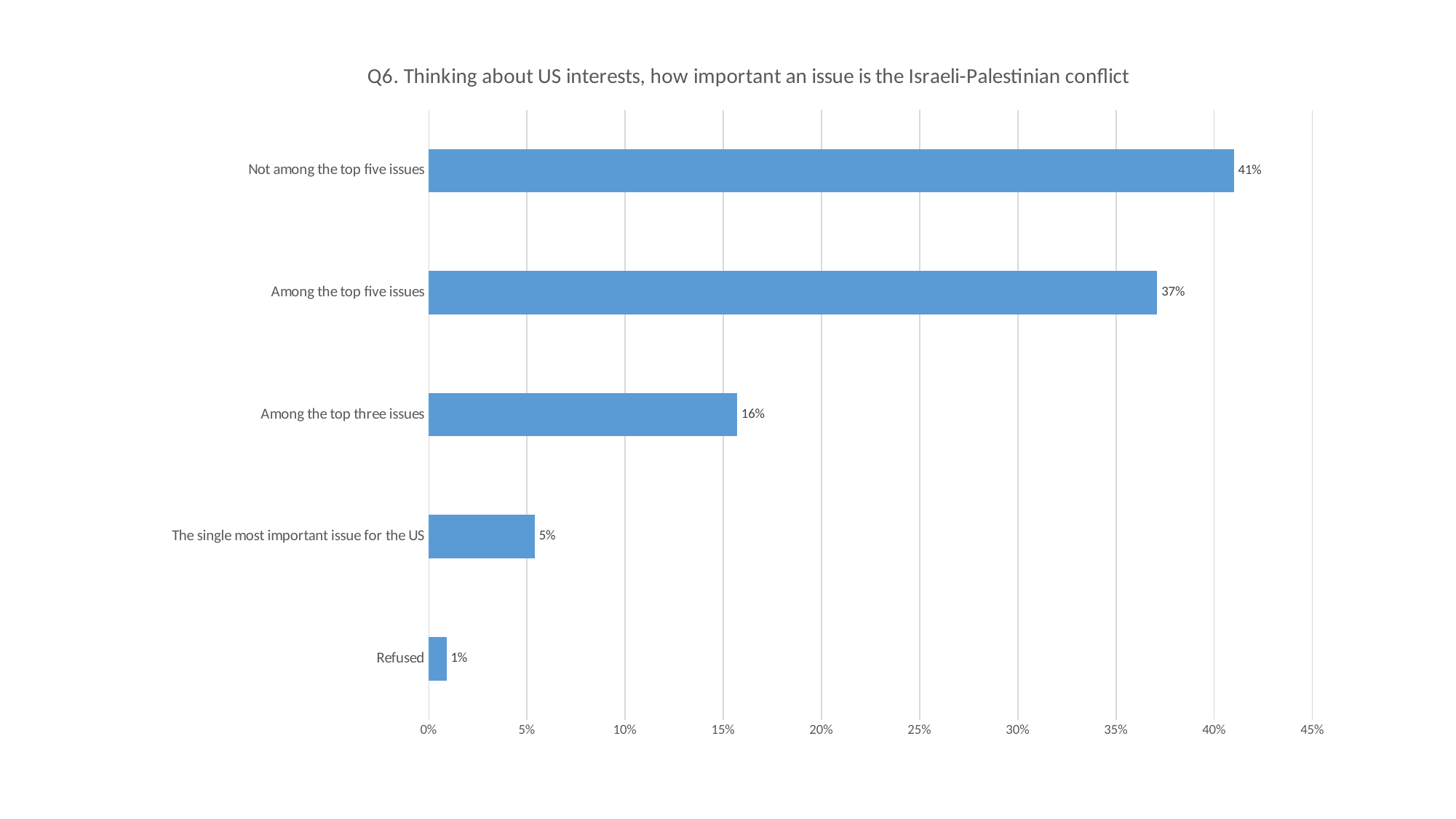
Which category has the highest value? Not among the top five issues What percentage of respondents said the Israeli-Palestinian conflict is not among the top five issues? 41% How many categories are shown in the chart? 5 What kind of chart is shown on the slide? Bar chart What percentage said the conflict is among the top three issues? 16% What is the title of the chart? Q6. Thinking about US interests, how important an issue is the Israeli-Palestinian conflict What is the value for "Among the top five issues"? 37% What percentage of respondents refused to answer? 1% Which is larger: "Among the top three issues" or "The single most important issue for the US"? Among the top three issues What is the difference between "Not among the top five issues" and "Among the top five issues"? 4% What is the value for "The single most important issue for the US"? 5% Which category has the lowest value? Refused